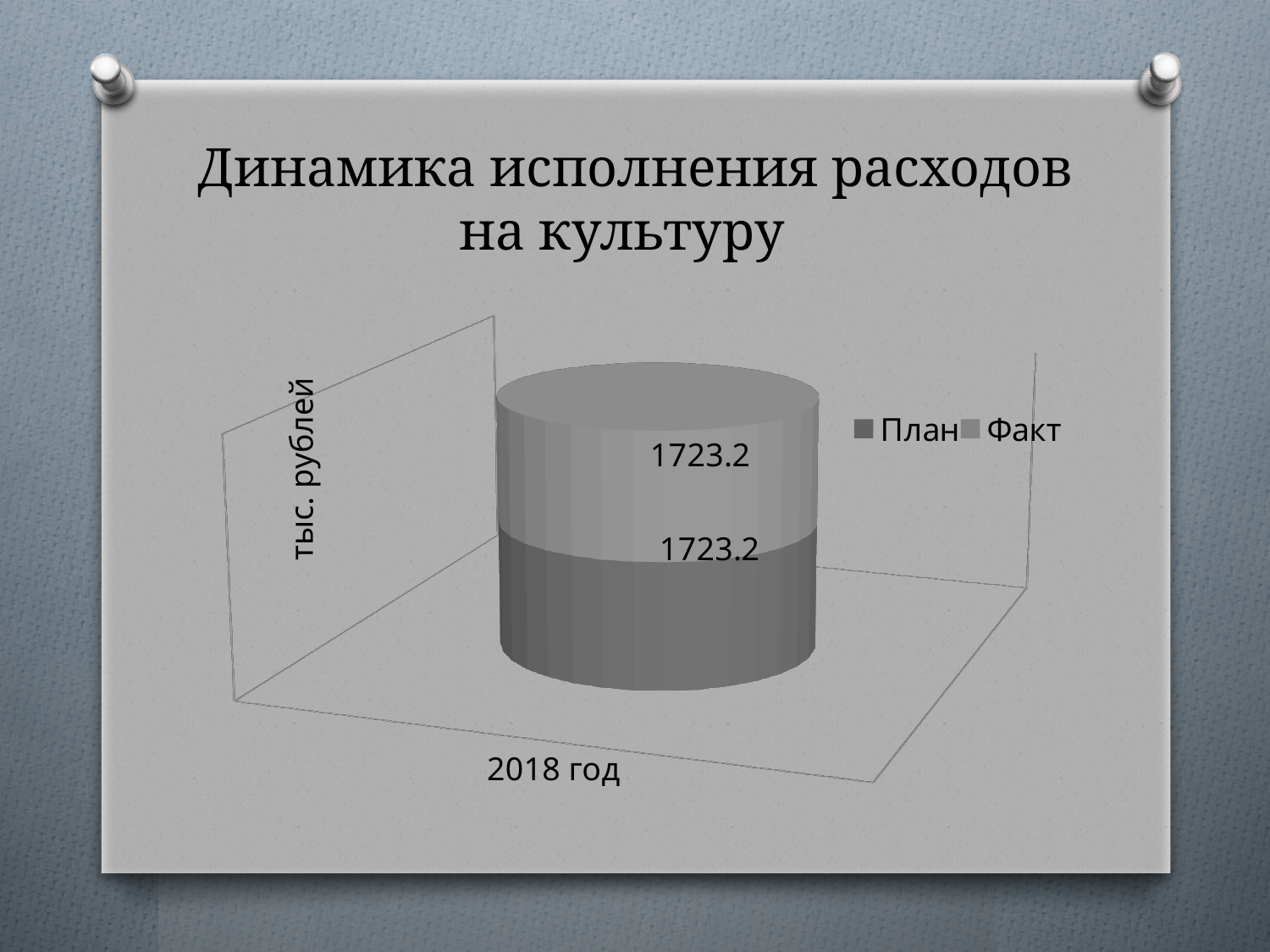
What is the total of the stacked bar for 2018 год? 3446.4 What is the value of the План series for 2018 год? 1723.2 How many categories are shown on the x axis of the chart? 1 Is the План value for 2018 год greater or less than 1000? greater What is the difference between the Факт and План values for 2018 год? 0 What is the title of the chart on the slide? Динамика исполнения расходов на культуру How many series does the legend list? 2 What kind of chart is shown on the slide? Bar chart What is the value of the Факт series for 2018 год? 1723.2 What unit is shown on the vertical axis label of the chart? тыс. рублей